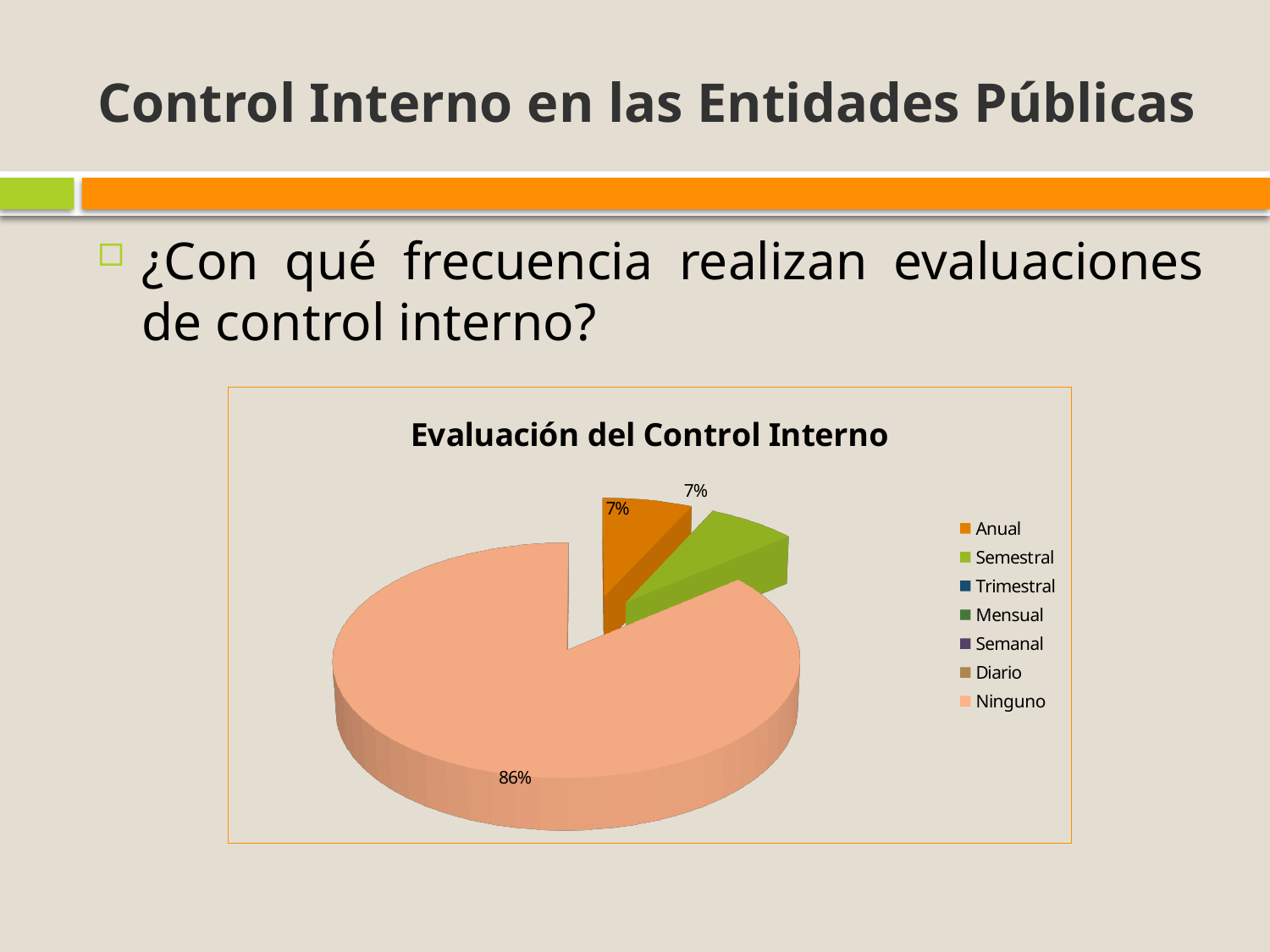
What percentage of the pie corresponds to Anual? 7% What is the difference in percentage points between the Ninguno slice and the Anual slice? 79 What share of the pie do Anual and Semestral make up together? 14% What percentage of the pie corresponds to Ninguno? 86% What percentage of the pie corresponds to Semestral? 7% What is the title of the chart? Evaluación del Control Interno Which is larger, the Ninguno slice or the Semestral slice? Ninguno What colour is the Semestral slice? green What kind of chart is shown on the slide? pie chart How many slices are visible in the pie? 3 Which category has the largest slice of the pie? Ninguno How many categories does the legend list? 7